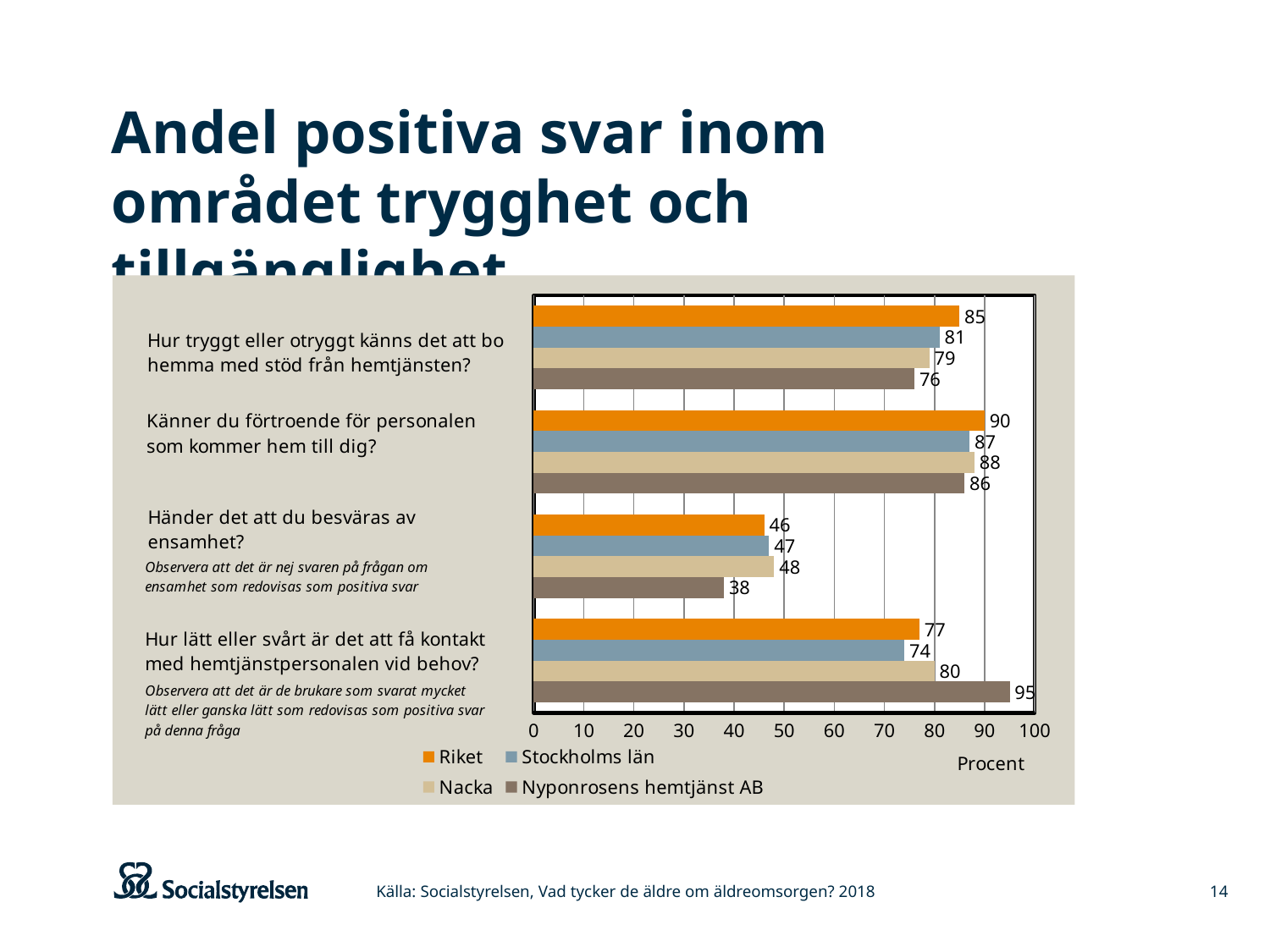
What is the value for Stockholms län on the question "Hur tryggt eller otryggt känns det att bo hemma med stöd från hemtjänsten?"? 81 Which is larger on the question "Känner du förtroende för personalen som kommer hem till dig?": Nacka or Nyponrosens hemtjänst AB? Nacka What kind of chart is shown on the slide? Bar chart How many series does the legend list? 4 Which series has the lowest value on the question "Händer det att du besväras av ensamhet?"? Nyponrosens hemtjänst AB What is the difference between Nyponrosens hemtjänst AB and Riket on the question "Hur lätt eller svårt är det att få kontakt med hemtjänstpersonalen vid behov?"? 18 What is the value for Nacka on the question "Händer det att du besväras av ensamhet?"? 48 What is the value for Nyponrosens hemtjänst AB on the question "Hur lätt eller svårt är det att få kontakt med hemtjänstpersonalen vid behov?"? 95 What is the value for Riket on the question "Känner du förtroende för personalen som kommer hem till dig?"? 90 Which series has the highest value on the question "Hur tryggt eller otryggt känns det att bo hemma med stöd från hemtjänsten?"? Riket What unit is shown on the x axis of the chart? Procent Is the value for Nyponrosens hemtjänst AB on the question "Händer det att du besväras av ensamhet?" greater or less than 40? less